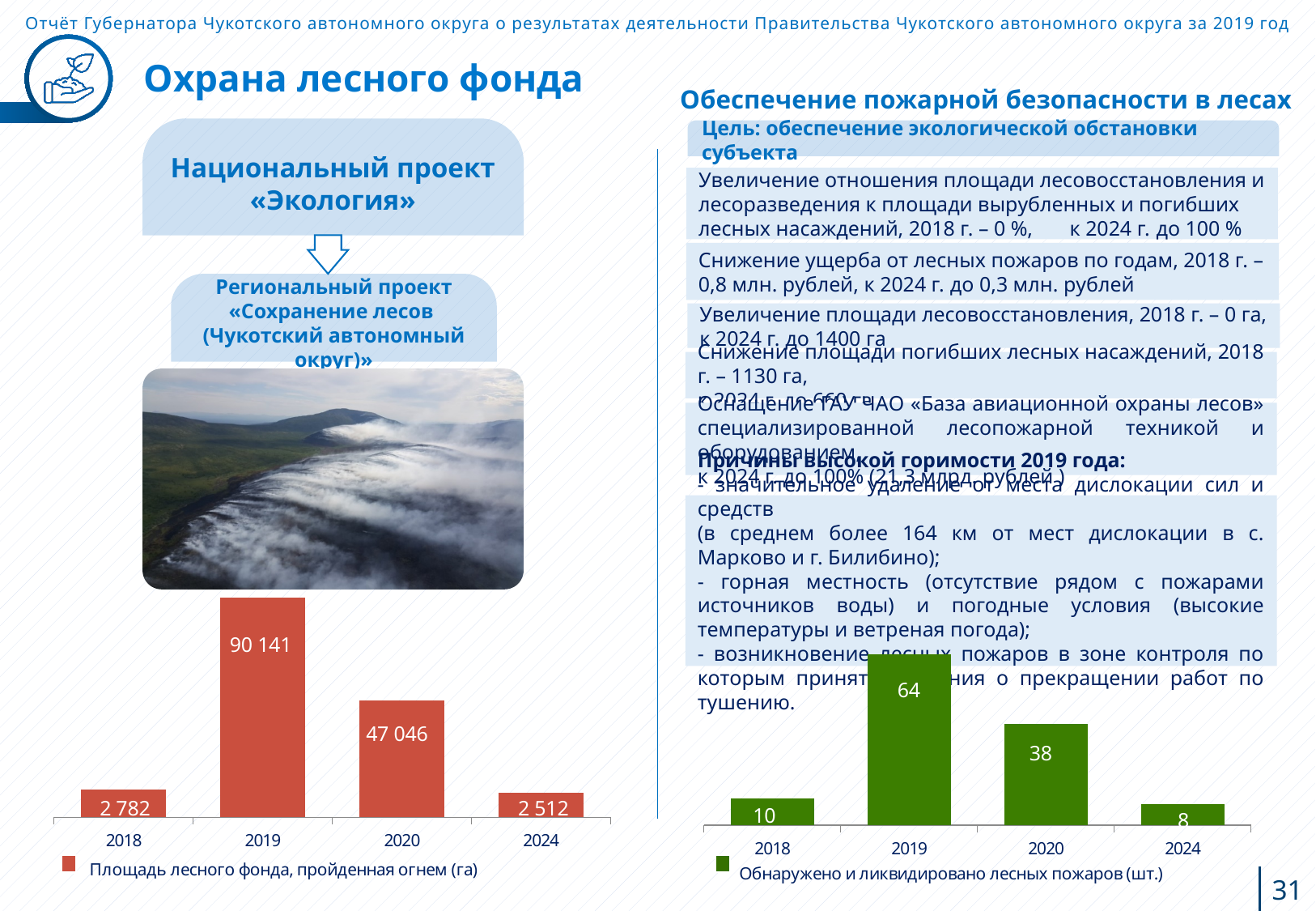
On the left chart (Площадь лесного фонда, пройденная огнем), how many years are shown on the x axis? 4 On the left chart (Площадь лесного фонда, пройденная огнем), which year has the lowest value? 2024 What kind of chart is the right chart (Обнаружено и ликвидировано лесных пожаров)? Bar chart On the right chart (Обнаружено и ликвидировано лесных пожаров), what is the value for 2018? 10 On the right chart (Обнаружено и ликвидировано лесных пожаров), which is larger, the value for 2018 or the value for 2024? 2018 On the left chart (Площадь лесного фонда, пройденная огнем), what is the difference between the 2019 and 2020 values? 43 095 On the right chart (Обнаружено и ликвидировано лесных пожаров), which year has the highest value? 2019 On the right chart (Обнаружено и ликвидировано лесных пожаров), what is the difference between the 2019 and 2020 values? 26 On the left chart (Площадь лесного фонда, пройденная огнем), what is the value for 2024? 2 512 On the left chart (Площадь лесного фонда, пройденная огнем), what is the value for 2019? 90 141 On the right chart (Обнаружено и ликвидировано лесных пожаров), what is the value for 2020? 38 On the left chart (Площадь лесного фонда, пройденная огнем), which year has the highest value? 2019